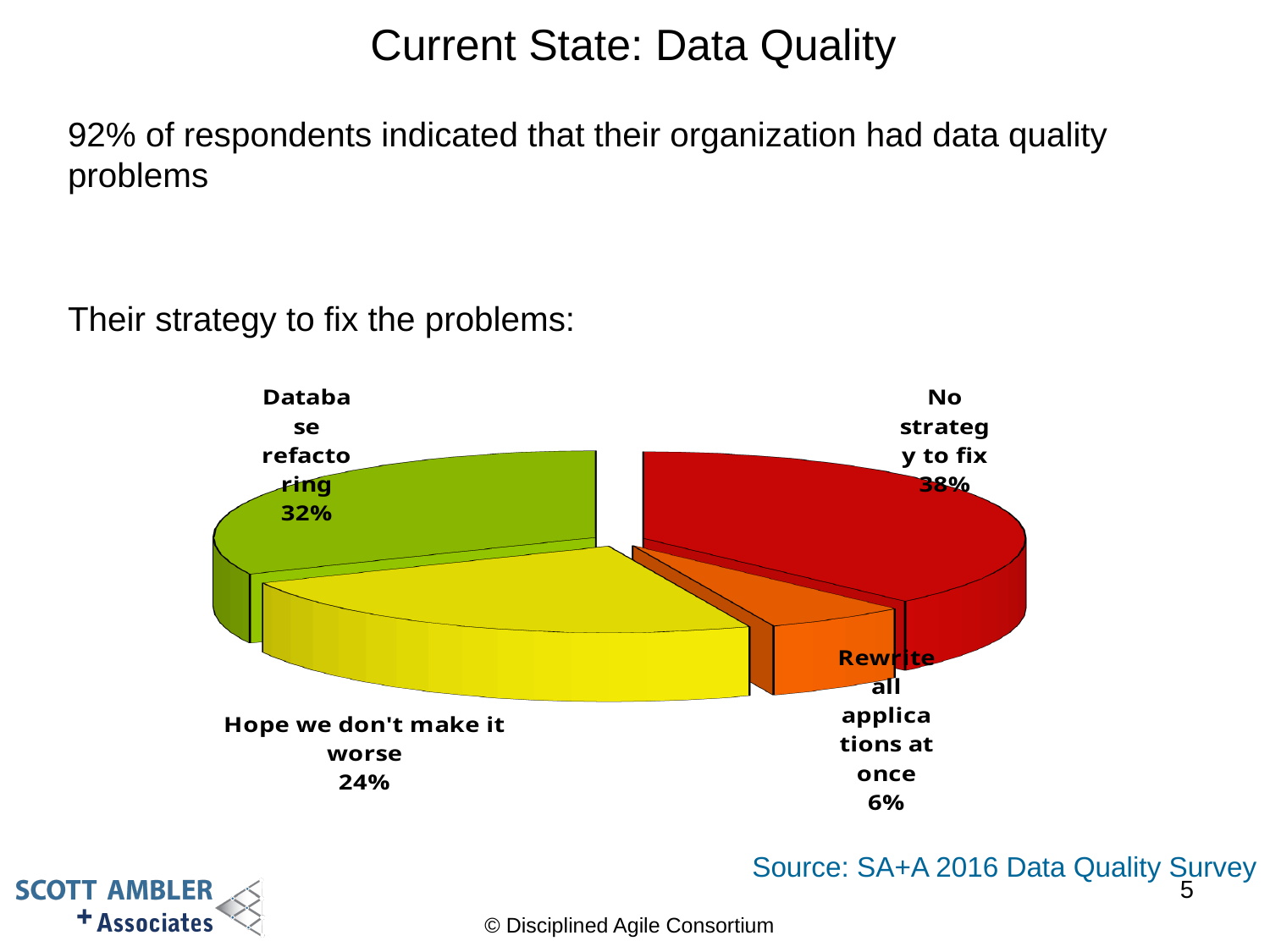
Which is larger: the share for "Hope we don't make it worse" or the share for "Rewrite all applications at once"? Hope we don't make it worse What share of respondents chose "Database refactoring"? 32% What share of respondents chose "Rewrite all applications at once"? 6% How many slices does the pie chart have? 4 What share of respondents chose "Hope we don't make it worse"? 24% Which strategy has the largest share of the pie? No strategy to fix What colour is the "No strategy to fix" slice? red What colour is the "Hope we don't make it worse" slice? yellow What kind of chart is shown on the slide? pie chart What is the difference in percentage points between "No strategy to fix" and "Database refactoring"? 6 Which strategy has the smallest share of the pie? Rewrite all applications at once What share of respondents chose "No strategy to fix"? 38%